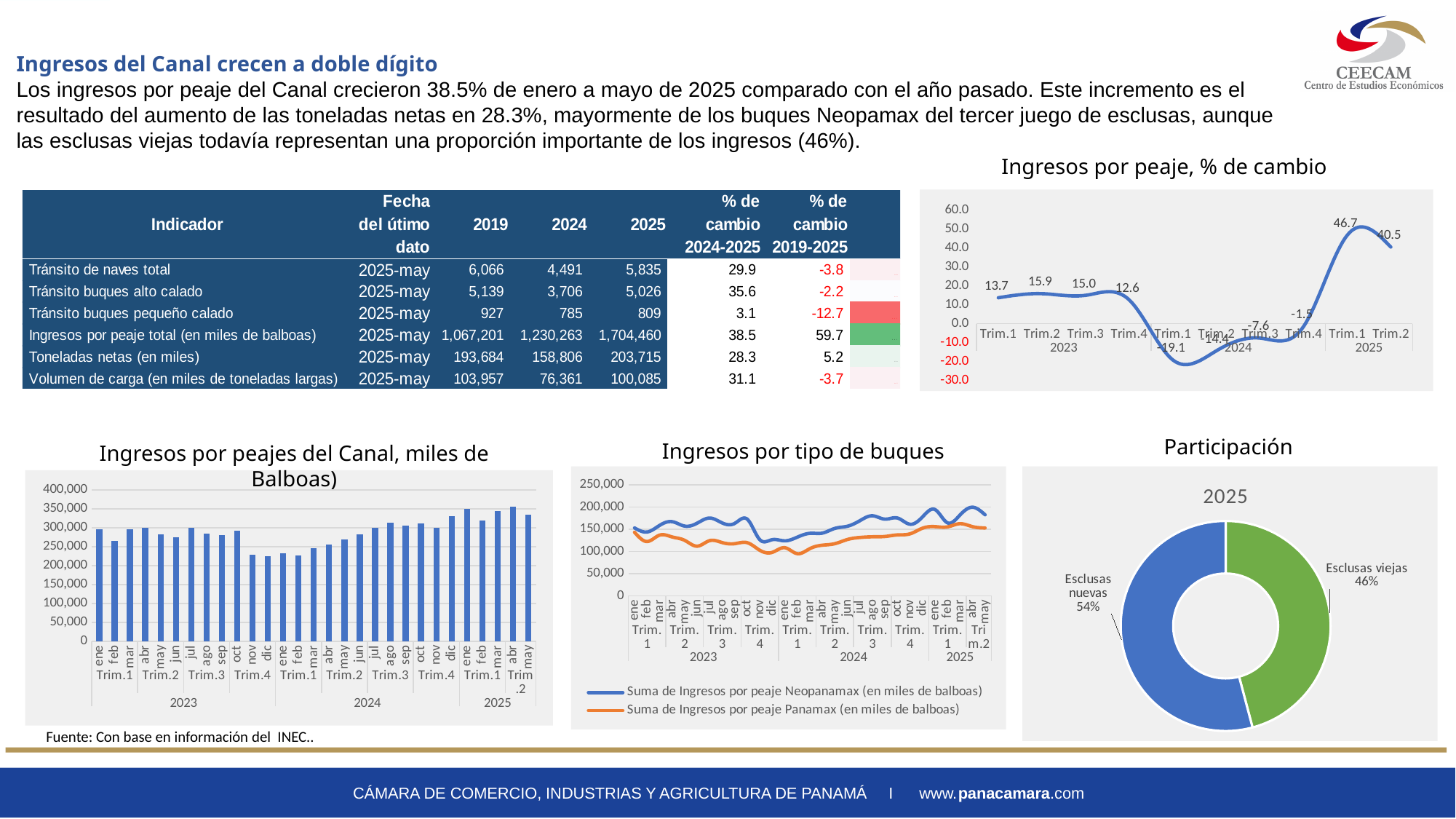
In the chart 'Participación', what share do Esclusas nuevas represent in 2025? 54% In the chart 'Ingresos por peaje, % de cambio', what is the value for Trim.1 2024? -19.1 In the chart 'Ingresos por peaje, % de cambio', which quarter has the highest value? Trim.1 2025 In the chart 'Ingresos por peajes del Canal, miles de Balboas)', is the value for feb 2025 greater or less than 300,000? greater In the chart 'Ingresos por peaje, % de cambio', what is the difference between the values for Trim.1 2025 and Trim.2 2025? 6.2 In the chart 'Ingresos por peaje, % de cambio', which quarter has the lowest value? Trim.1 2024 In the chart 'Ingresos por peajes del Canal, miles de Balboas)', is the value for nov 2023 greater or less than 250,000? less In the chart 'Ingresos por peaje, % de cambio', what is the value for Trim.1 2025? 46.7 In the chart 'Ingresos por peaje, % de cambio', how many data points are plotted? 10 How many series does the legend of the chart 'Ingresos por tipo de buques' list? 2 In the chart 'Participación', which slice is larger, Esclusas nuevas or Esclusas viejas? Esclusas nuevas What kind of chart is 'Ingresos por peajes del Canal, miles de Balboas)'? Bar chart